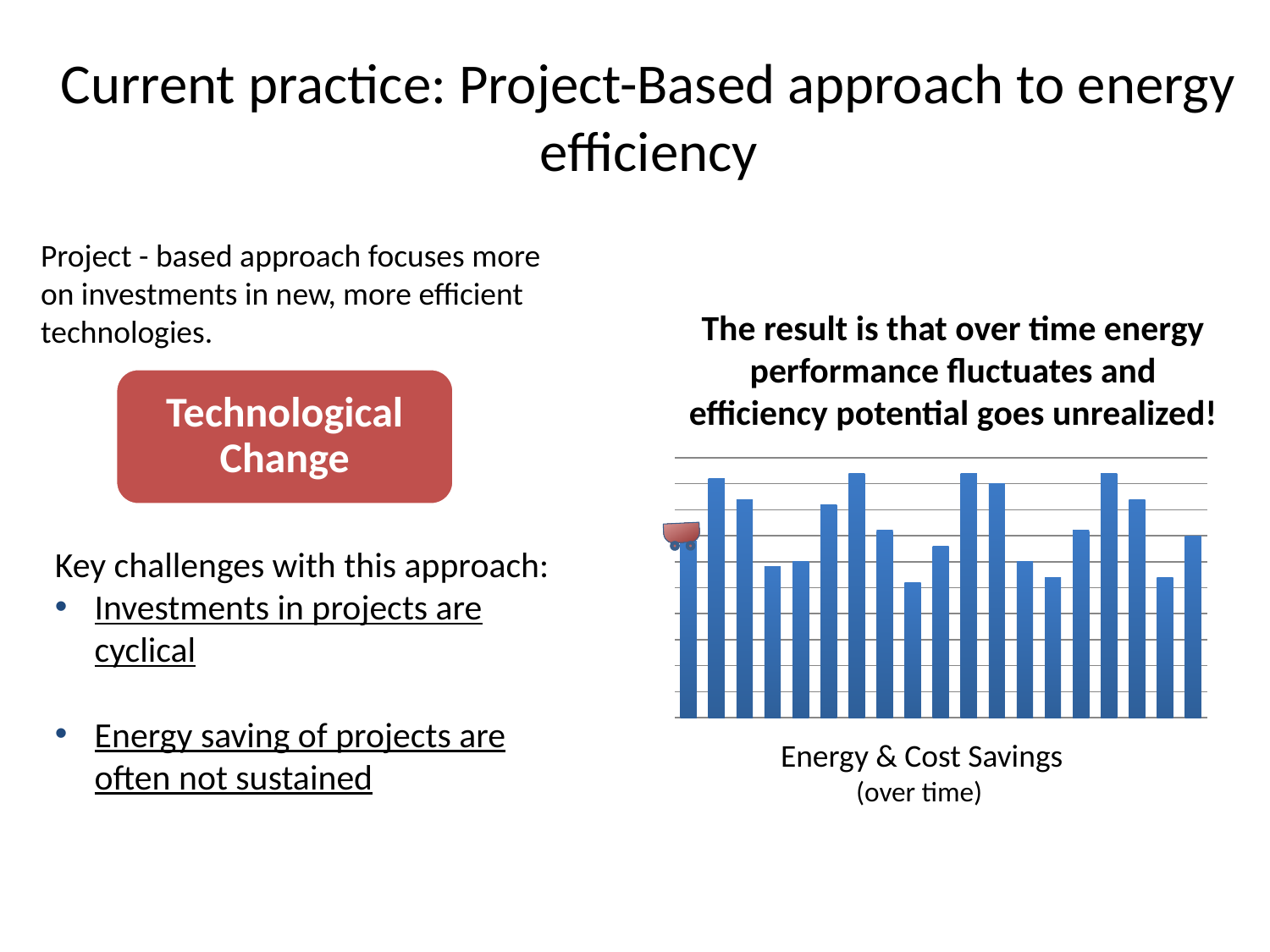
What caption appears below the bar chart on the right of the slide? Energy & Cost Savings (over time) In the bar chart on the right, is the second bar from the left taller or shorter than the fourth bar from the left? taller What colour are the bars in the chart on the right of the slide? blue How many bars are plotted in the chart on the right of the slide? 19 In the bar chart on the right, is the rightmost bar taller or shorter than the bar immediately to its left? taller Do the bar heights in the chart on the right rise steadily, fall steadily, or fluctuate up and down along the x axis? fluctuate up and down What kind of chart is shown under the heading 'The result is that over time energy performance fluctuates and efficiency potential goes unrealized!'? bar chart